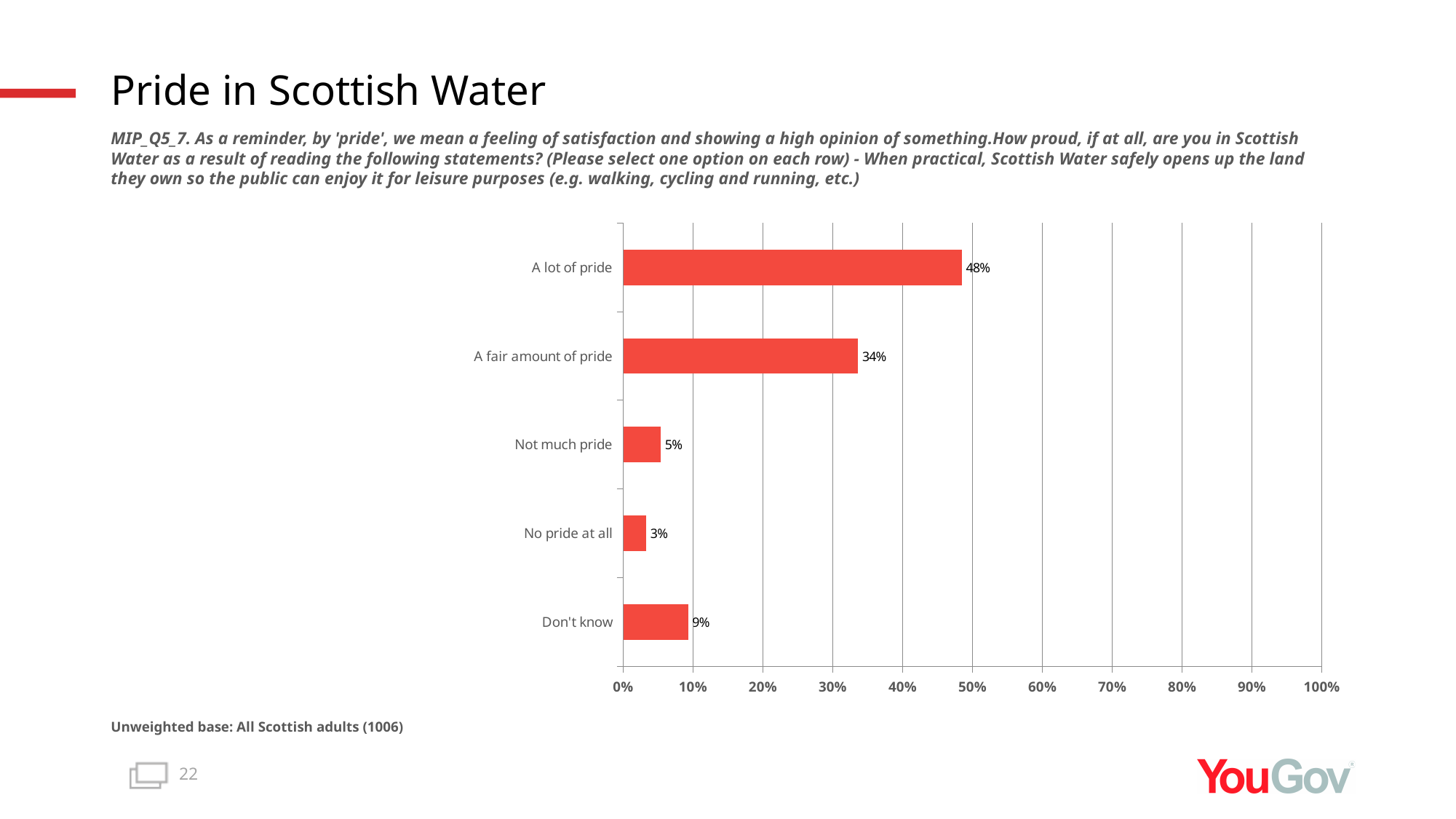
Which category has the highest value? A lot of pride What is the difference between 'A lot of pride' and 'A fair amount of pride'? 14% How many categories are shown in the chart? 5 Which is larger: 'Not much pride' or 'Don't know'? Don't know What is the unweighted base stated below the chart? All Scottish adults (1006) Is the value for 'A lot of pride' greater or less than 50%? less What is the value for 'No pride at all'? 3% Which category has the lowest value? No pride at all What percentage of respondents said they feel 'A lot of pride'? 48% What percentage answered 'Don't know'? 9% What is the value for 'A fair amount of pride'? 34% What kind of chart is shown on the slide? Bar chart